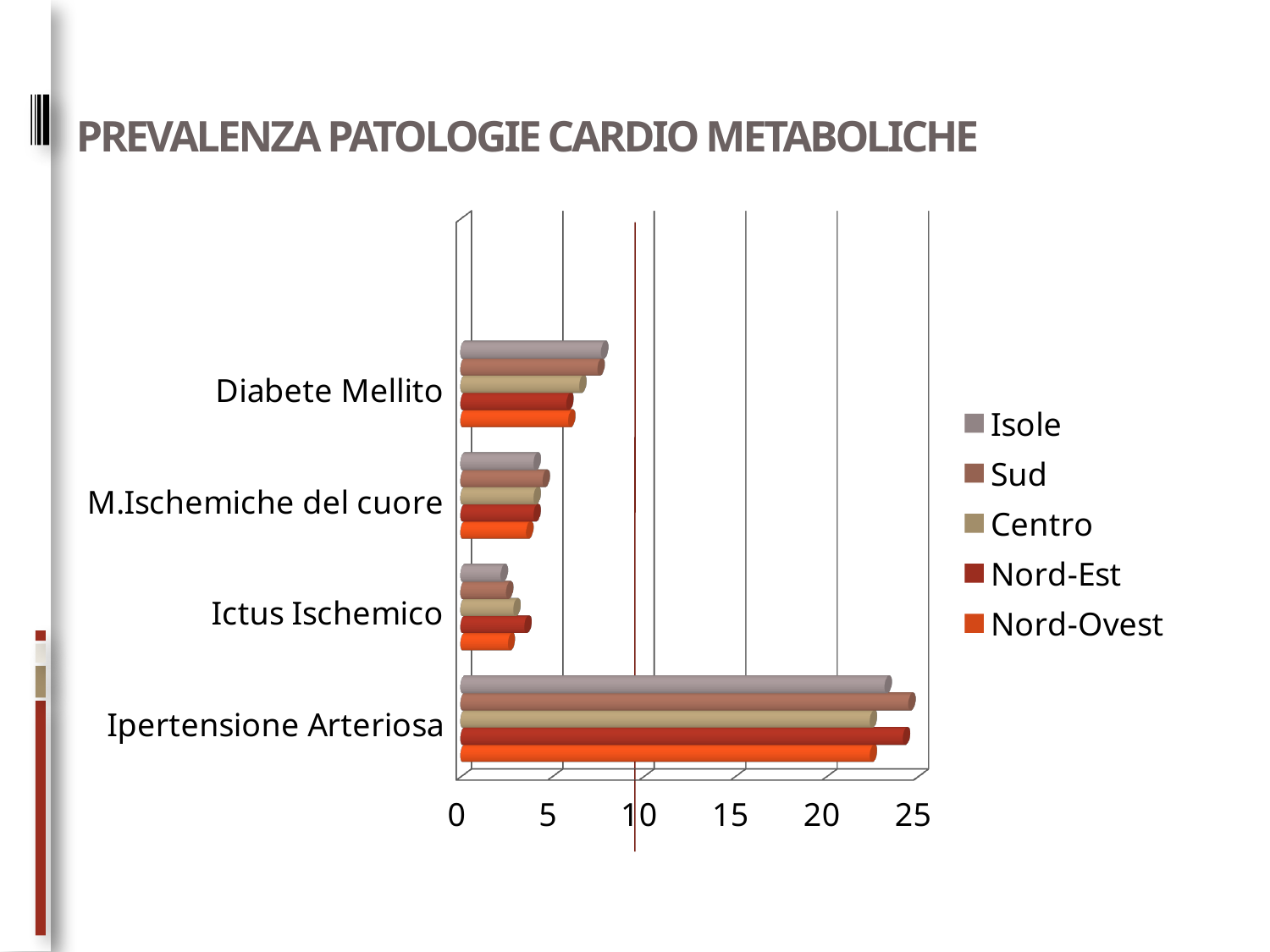
Is the value for Diabete Mellito in the Isole series greater or less than 10? less Is the value for Ipertensione Arteriosa in the Sud series greater or less than 20? greater Which series is shown in orange in the legend? Nord-Ovest What kind of chart is shown on the slide? bar chart How many disease categories are shown on the chart? 4 For the Isole series, which is larger: Ipertensione Arteriosa or Diabete Mellito? Ipertensione Arteriosa For Diabete Mellito, which series has the larger value: Isole or Centro? Isole Is the value for Ictus Ischemico in the Nord-Est series greater or less than 5? less Which category has the highest values across all series? Ipertensione Arteriosa Which category has the lowest values across all series? Ictus Ischemico What is the title of the slide? PREVALENZA PATOLOGIE CARDIO METABOLICHE How many series does the legend list? 5